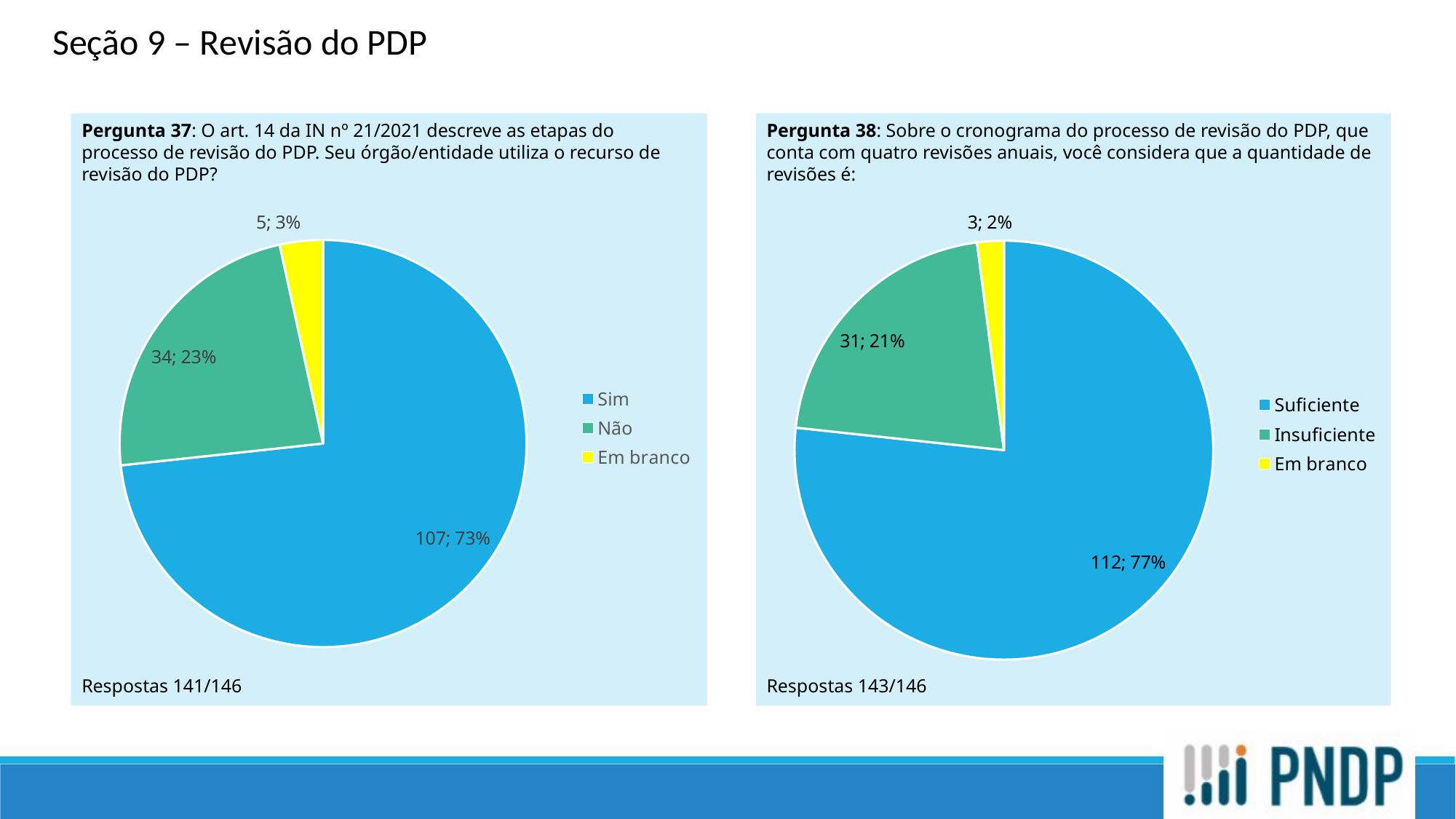
In the Pergunta 37 chart (left), how many entries does the legend list? 3 In the Pergunta 38 chart (right), how many respondents answered "Insuficiente"? 31 In the Pergunta 37 chart (left), which category has the smallest slice? Em branco In the Pergunta 38 chart (right), what colour is the "Em branco" slice? Yellow In the Pergunta 37 chart (left), how many respondents answered "Sim"? 107 In the Pergunta 37 chart (left), what is the difference in count between "Sim" and "Não"? 73 In the Pergunta 38 chart (right), what share of the pie does "Suficiente" represent? 77% What type of chart is used for Pergunta 37 (left)? Pie chart In the Pergunta 38 chart (right), which is larger: "Insuficiente" or "Em branco"? Insuficiente In the Pergunta 38 chart (right), what is the difference in count between "Suficiente" and "Insuficiente"? 81 In the Pergunta 38 chart (right), which category has the largest slice? Suficiente In the Pergunta 37 chart (left), what share of the pie does "Não" represent? 23%